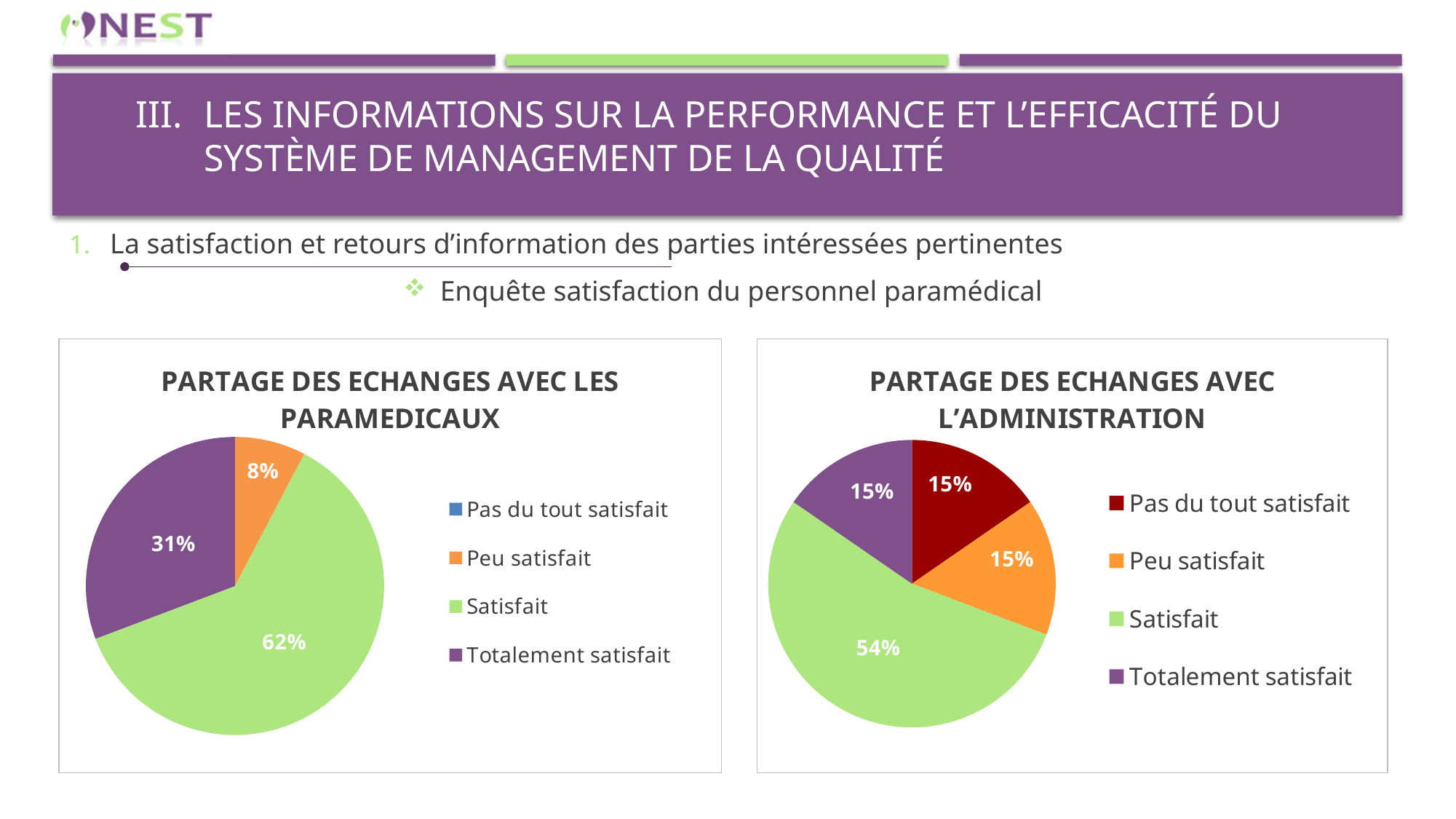
In the chart "PARTAGE DES ECHANGES AVEC L'ADMINISTRATION", what share is labelled for Pas du tout satisfait? 15% In the chart "PARTAGE DES ECHANGES AVEC LES PARAMEDICAUX", which category has the largest slice? Satisfait In the chart "PARTAGE DES ECHANGES AVEC LES PARAMEDICAUX", what share is labelled for Totalement satisfait? 31% Which chart shows a larger share for Satisfait: "PARTAGE DES ECHANGES AVEC LES PARAMEDICAUX" or "PARTAGE DES ECHANGES AVEC L'ADMINISTRATION"? PARTAGE DES ECHANGES AVEC LES PARAMEDICAUX How many entries does the legend of the chart "PARTAGE DES ECHANGES AVEC LES PARAMEDICAUX" list? 4 In the chart "PARTAGE DES ECHANGES AVEC L'ADMINISTRATION", which category has the largest slice? Satisfait What type of chart is "PARTAGE DES ECHANGES AVEC LES PARAMEDICAUX"? Pie chart In the chart "PARTAGE DES ECHANGES AVEC LES PARAMEDICAUX", what share is labelled for Satisfait? 62% In the chart "PARTAGE DES ECHANGES AVEC LES PARAMEDICAUX", what is the difference between the Satisfait and Totalement satisfait shares? 31% In the chart "PARTAGE DES ECHANGES AVEC L'ADMINISTRATION", what colour is the Pas du tout satisfait slice? Dark red